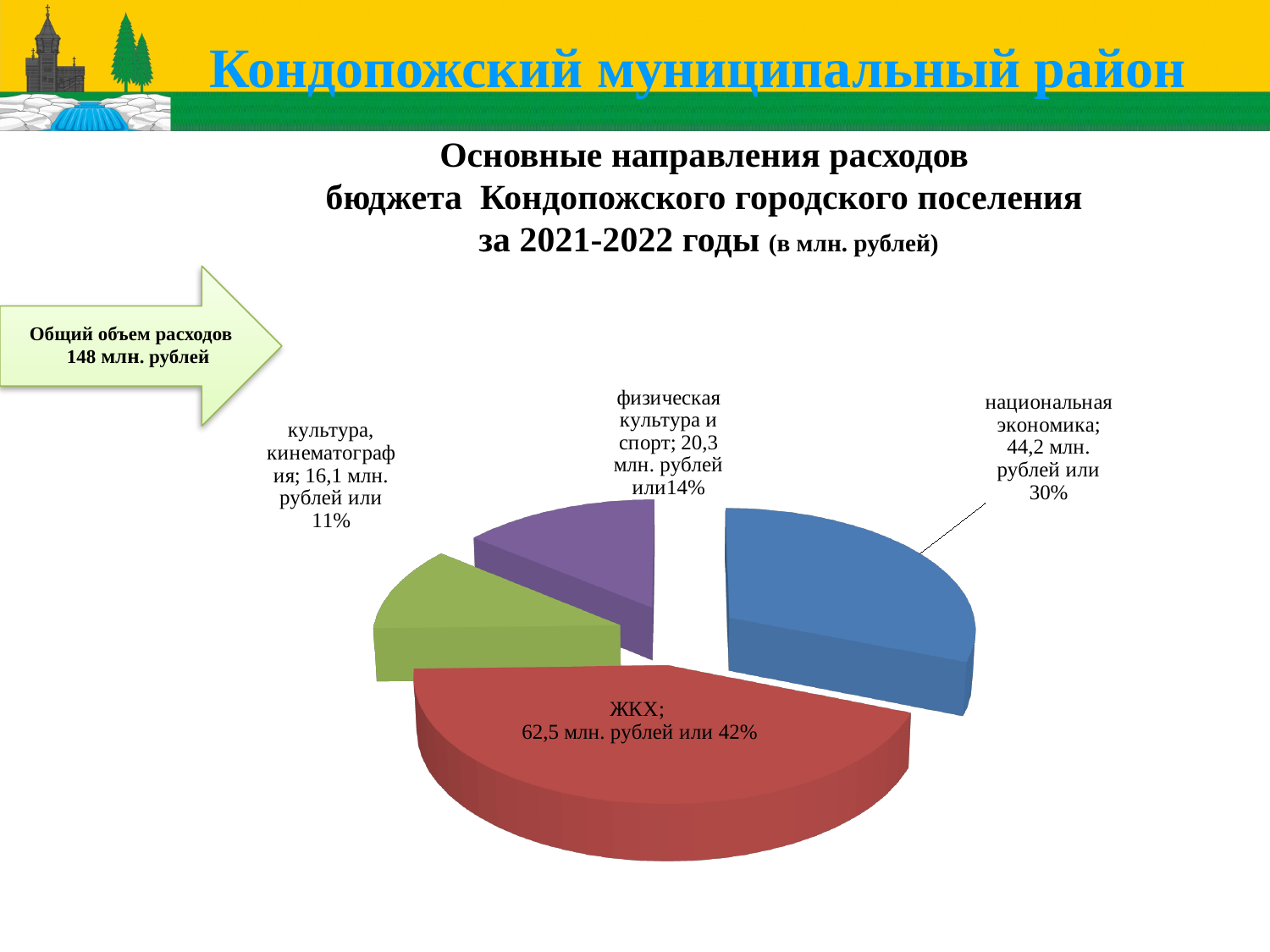
What share of the pie does национальная экономика represent? 30% How many slices does the pie chart have? 4 What share of the pie does физическая культура и спорт represent? 14% What is the difference between the values for ЖКХ and национальная экономика? 18,3 млн. рублей Which category has the smallest share of the pie chart? культура, кинематография What kind of chart is shown on the slide? Pie chart What is the value for культура, кинематография in the pie chart? 16,1 млн. рублей Which is larger, the value for ЖКХ or the value for национальная экономика? ЖКХ What is the value for физическая культура и спорт in the pie chart? 20,3 млн. рублей Which category has the largest share of the pie chart? ЖКХ What is the value for ЖКХ in the pie chart? 62,5 млн. рублей What is the value for национальная экономика in the pie chart? 44,2 млн. рублей